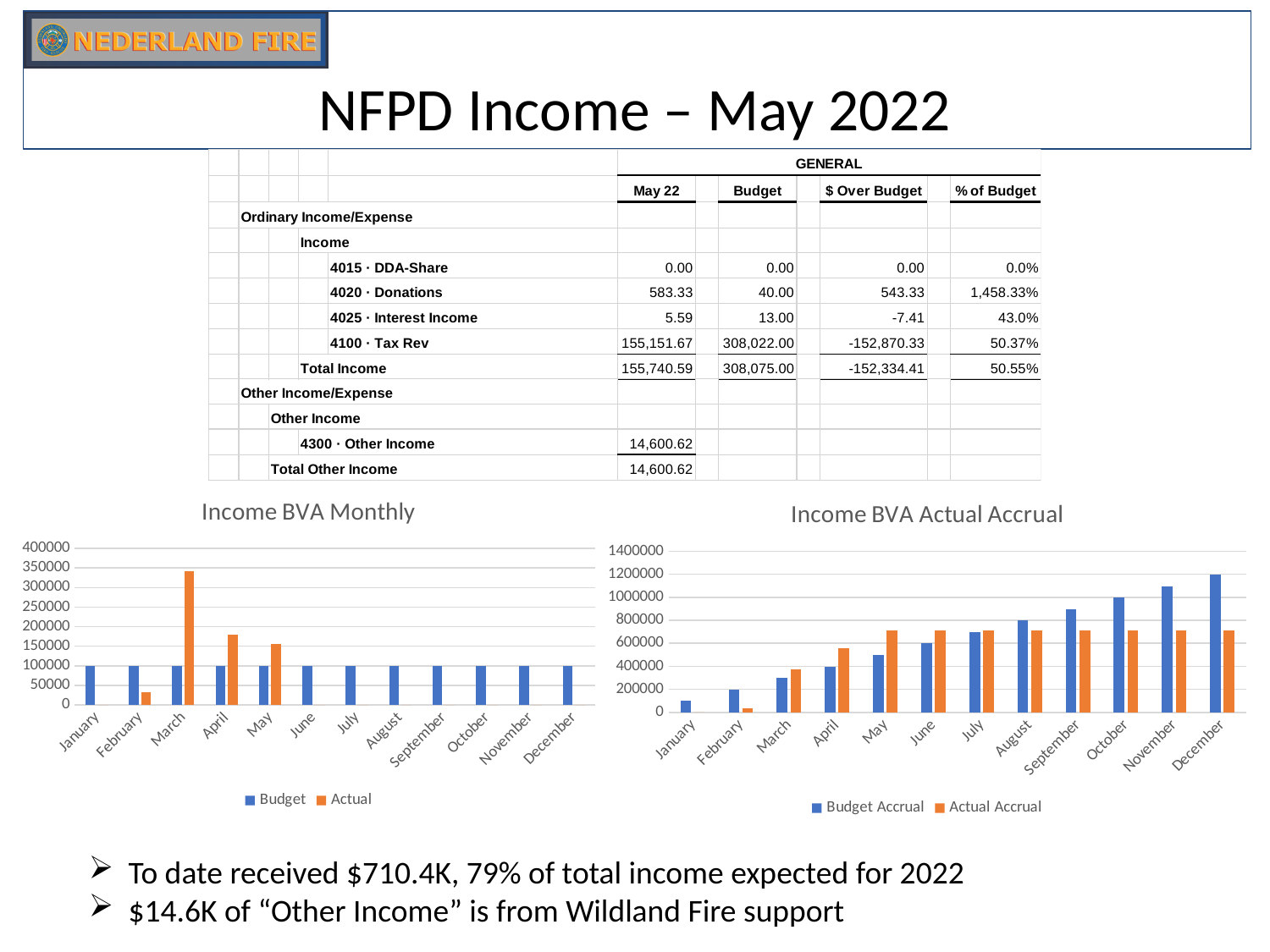
In the Income BVA Actual Accrual chart, which month has the highest Budget Accrual value? December In the Income BVA Monthly chart, which is larger for April, Budget or Actual? Actual In the Income BVA Monthly chart, is the Actual value for February greater or less than 50000? less In the Income BVA Actual Accrual chart, which is larger for May, Budget Accrual or Actual Accrual? Actual Accrual In the Income BVA Monthly chart, which month has the highest Actual value? March In the Income BVA Monthly chart, is the Actual value for March greater or less than 300000? greater What kind of chart is the Income BVA Monthly chart? bar chart How many months are shown on the x axis of the Income BVA Monthly chart? 12 What are the two legend entries of the Income BVA Actual Accrual chart? Budget Accrual and Actual Accrual In the Income BVA Actual Accrual chart, does the Budget Accrual series rise or fall from January to December? rise In the Income BVA Actual Accrual chart, is the Actual Accrual value for December greater or less than 800000? less How many series does the legend of the Income BVA Actual Accrual chart list? 2